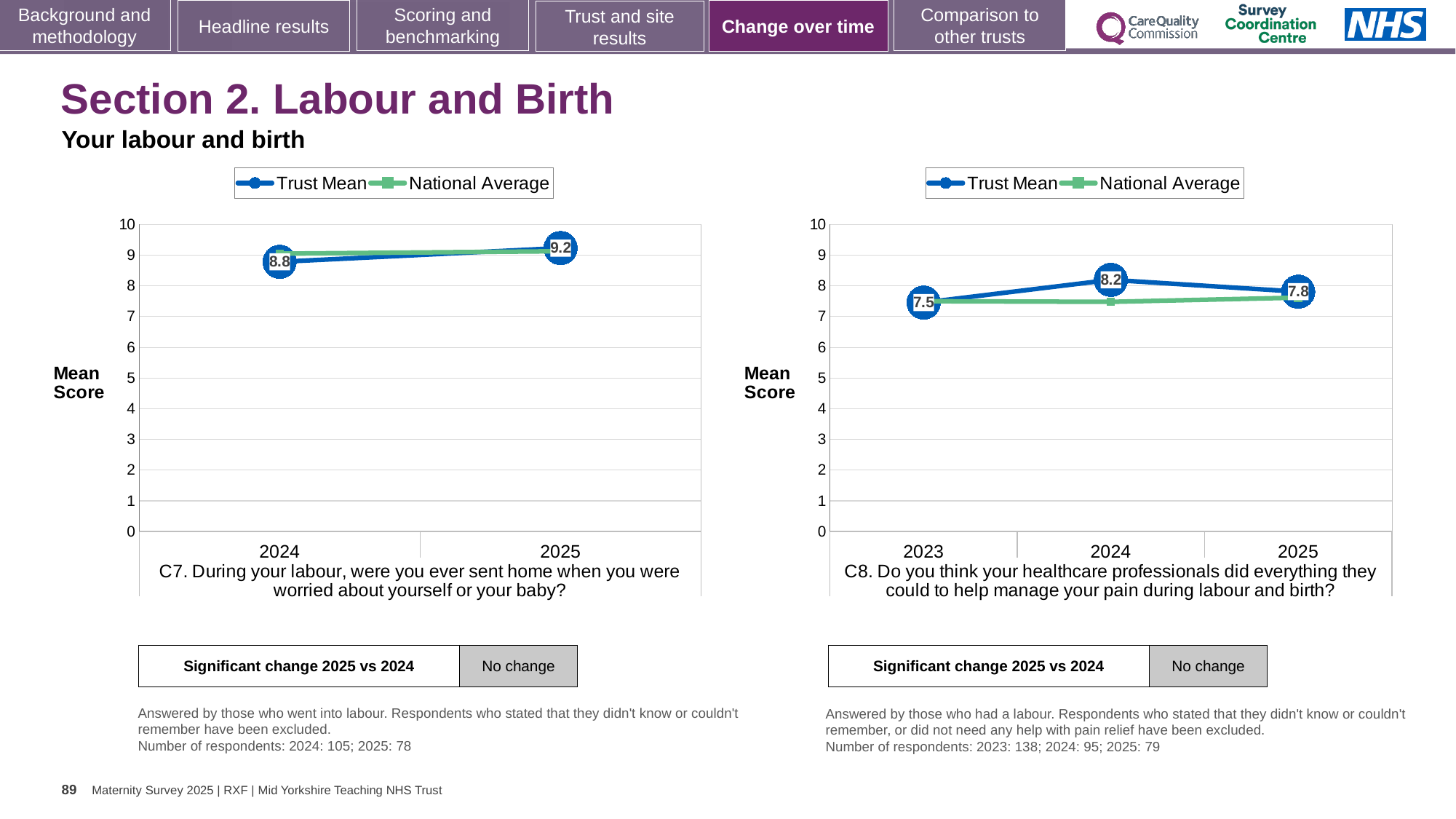
In the C8 chart (right), what is the Trust Mean for 2024? 8.2 In the C7 chart (left), is the National Average for 2024 greater or less than 8? greater In the C7 chart (left), what is the Trust Mean for 2025? 9.2 In the C7 chart (left), what is the Trust Mean for 2024? 8.8 In the C8 chart (right), which year has the highest Trust Mean? 2024 In the C8 chart (right), what is the Trust Mean for 2023? 7.5 In the C7 chart (left), by how much did the Trust Mean change from 2024 to 2025? 0.4 How many years are plotted on the x axis of the C8 chart (right)? 3 In the C8 chart (right), what is the difference between the Trust Mean for 2024 and 2025? 0.4 In the C8 chart (right), which year has the lowest Trust Mean? 2023 In the C8 chart (right), is the Trust Mean for 2024 larger or smaller than the National Average for 2024? larger How many series does the legend of the C7 chart (left) list? 2